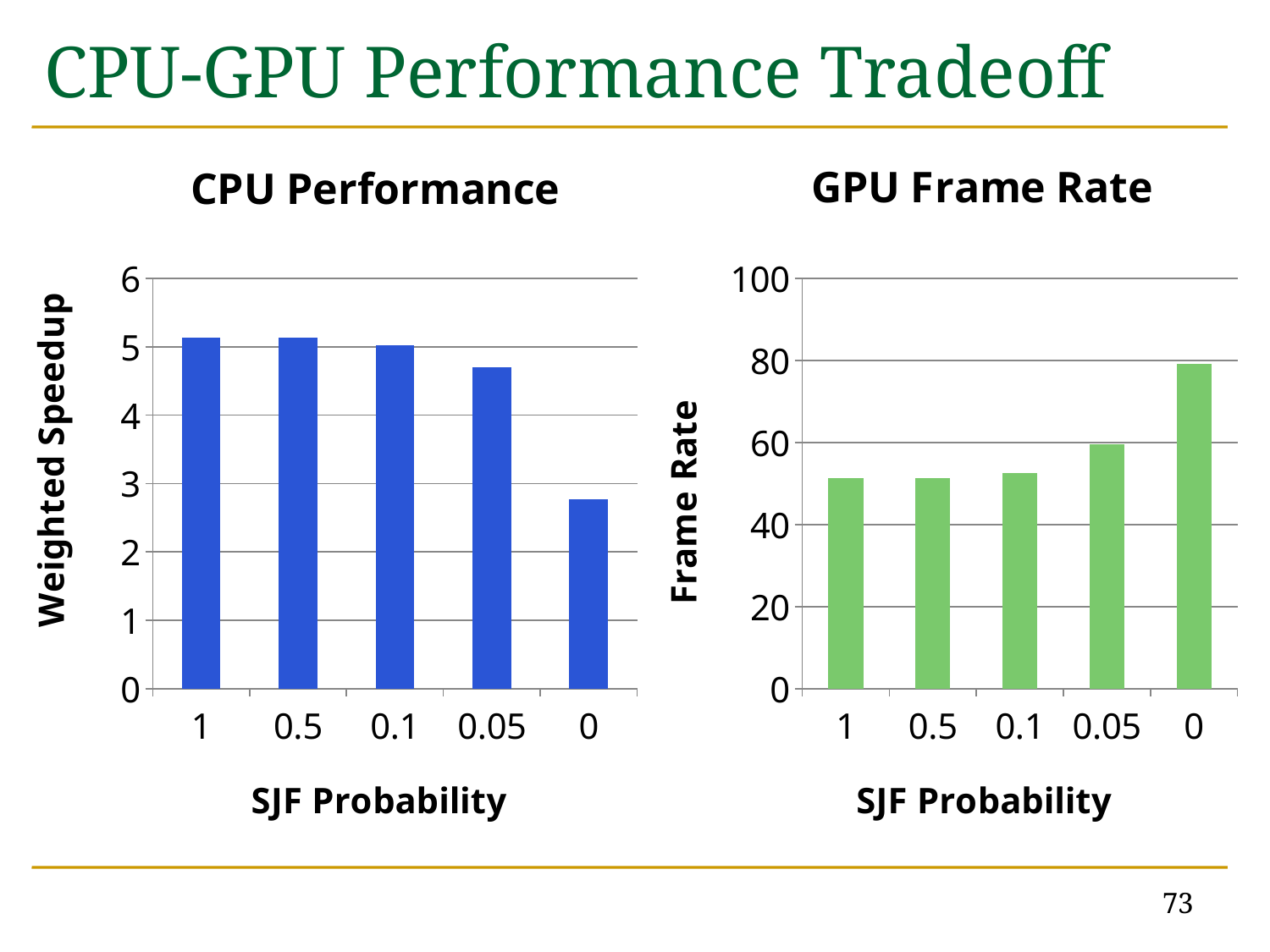
In the CPU Performance chart, is the weighted speedup for SJF Probability 1 greater or less than 5? greater In the GPU Frame Rate chart, which is larger: the frame rate for SJF Probability 0.05 or for SJF Probability 0.1? 0.05 What is the y-axis title of the CPU Performance chart? Weighted Speedup In the GPU Frame Rate chart, which SJF Probability has the highest frame rate? 0 In the CPU Performance chart, what kind of chart is shown? bar chart In the GPU Frame Rate chart, is the frame rate for SJF Probability 0 greater or less than 60? greater In the CPU Performance chart, which is larger: the weighted speedup for SJF Probability 0.05 or for SJF Probability 0? 0.05 In the CPU Performance chart, is the weighted speedup for SJF Probability 0 greater or less than 3? less In the GPU Frame Rate chart, how many SJF Probability categories are plotted? 5 In the CPU Performance chart, which SJF Probability has the lowest weighted speedup? 0 In the GPU Frame Rate chart, do the frame rate values generally rise or fall moving from SJF Probability 1 to 0 along the x axis? rise